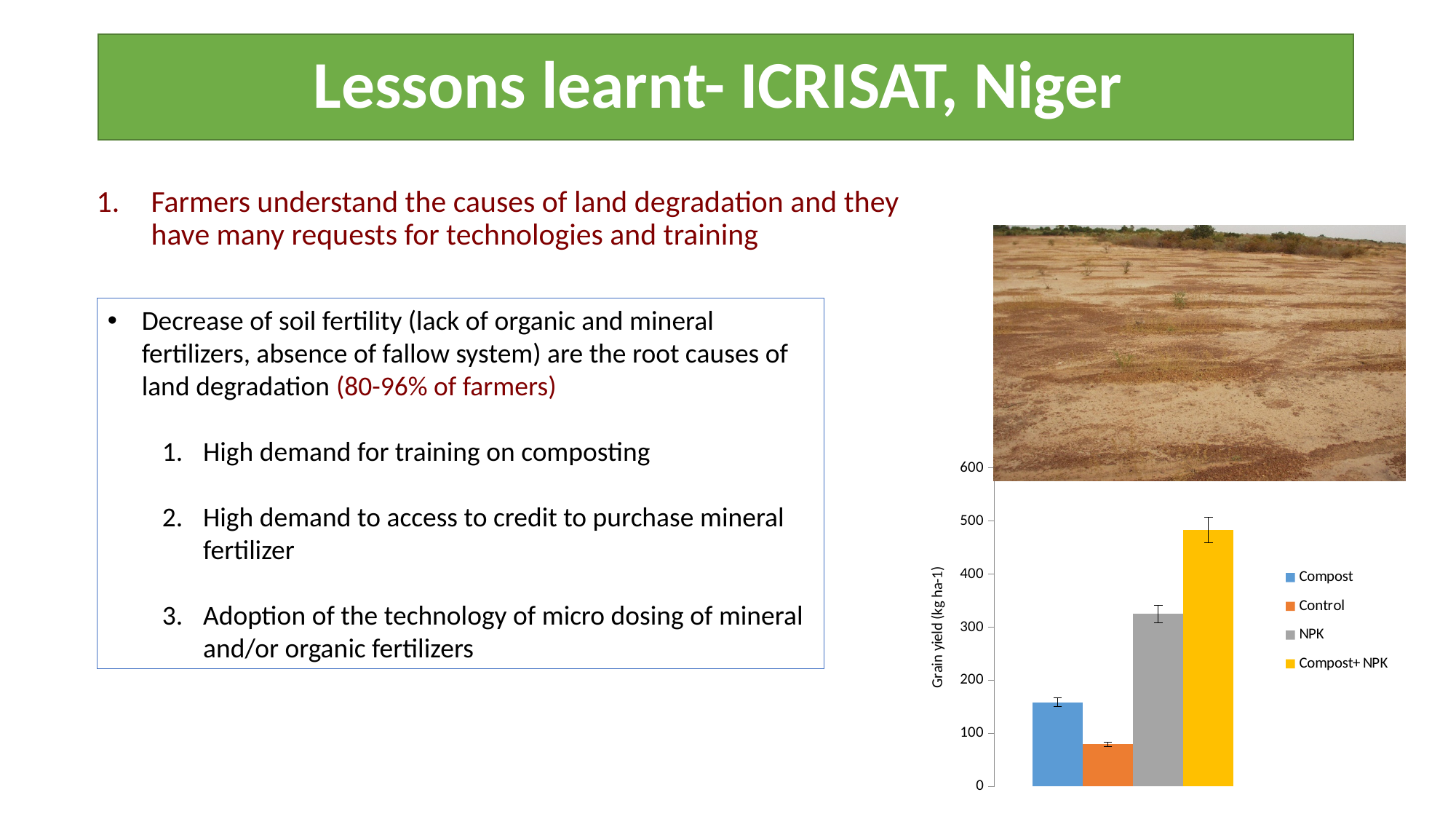
Is the grain yield for NPK greater or less than 300? greater Which treatment has the highest grain yield in the chart? Compost+ NPK What is the label of the chart's vertical axis? Grain yield (kg ha-1) Which treatment has the lowest grain yield in the chart? Control How many series does the chart's legend list? 4 How many bars are plotted in the chart? 4 Which has the larger grain yield, Compost or Control? Compost Is the grain yield for Control greater or less than 100? less Is the grain yield for Compost greater or less than 200? less What kind of chart is shown on the slide? bar chart Which has the larger grain yield, NPK or Compost? NPK